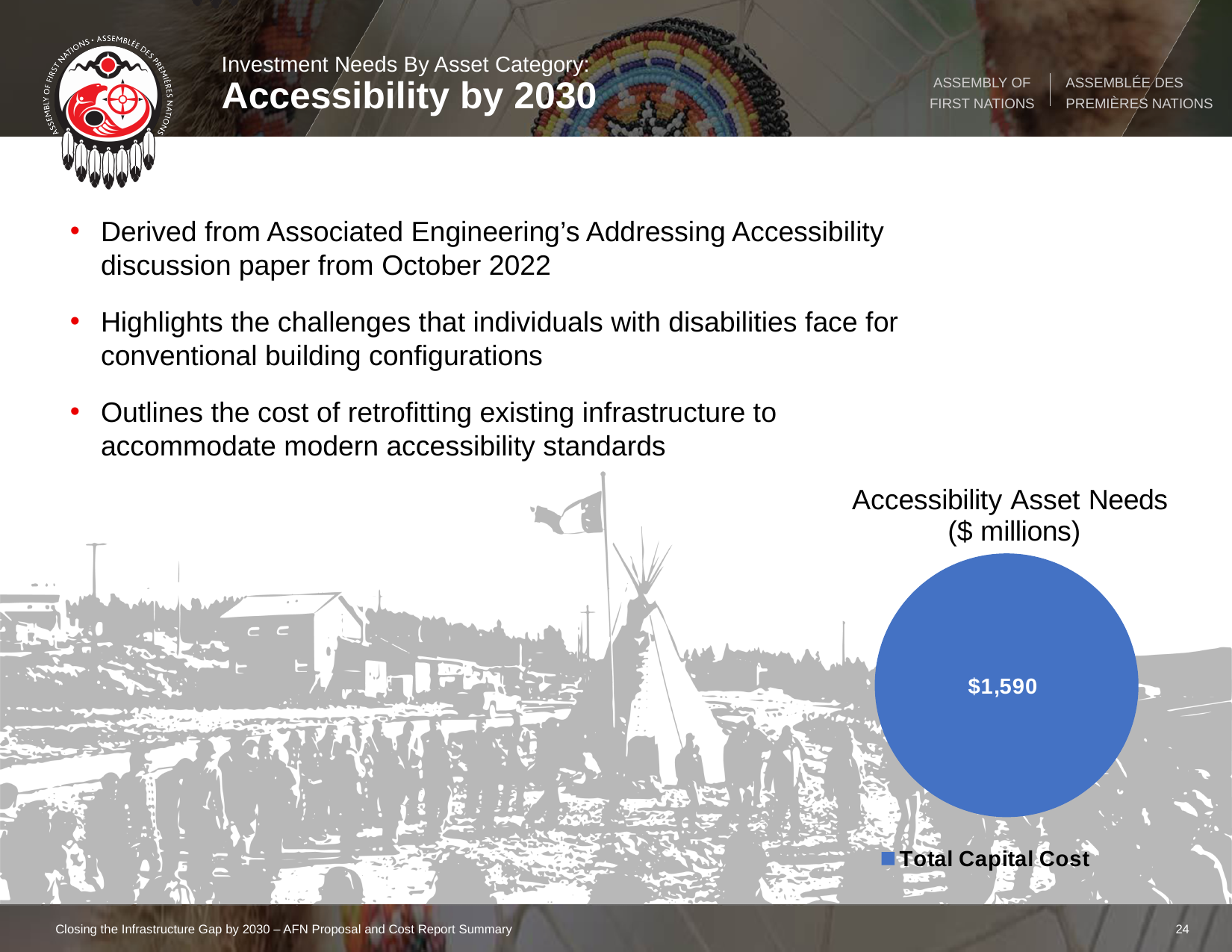
In what units are the values in the Accessibility Asset Needs chart expressed? $ millions What is the title of the chart on the slide? Accessibility Asset Needs ($ millions) How many slices does the Accessibility Asset Needs pie chart have? 1 What is the value shown for Total Capital Cost in the Accessibility Asset Needs chart? $1,590 What kind of chart is used to show Accessibility Asset Needs? pie chart What share of the Accessibility Asset Needs pie does the Total Capital Cost slice represent? 100% How many entries does the legend of the Accessibility Asset Needs chart list? 1 What is the name of the only legend entry in the Accessibility Asset Needs chart? Total Capital Cost